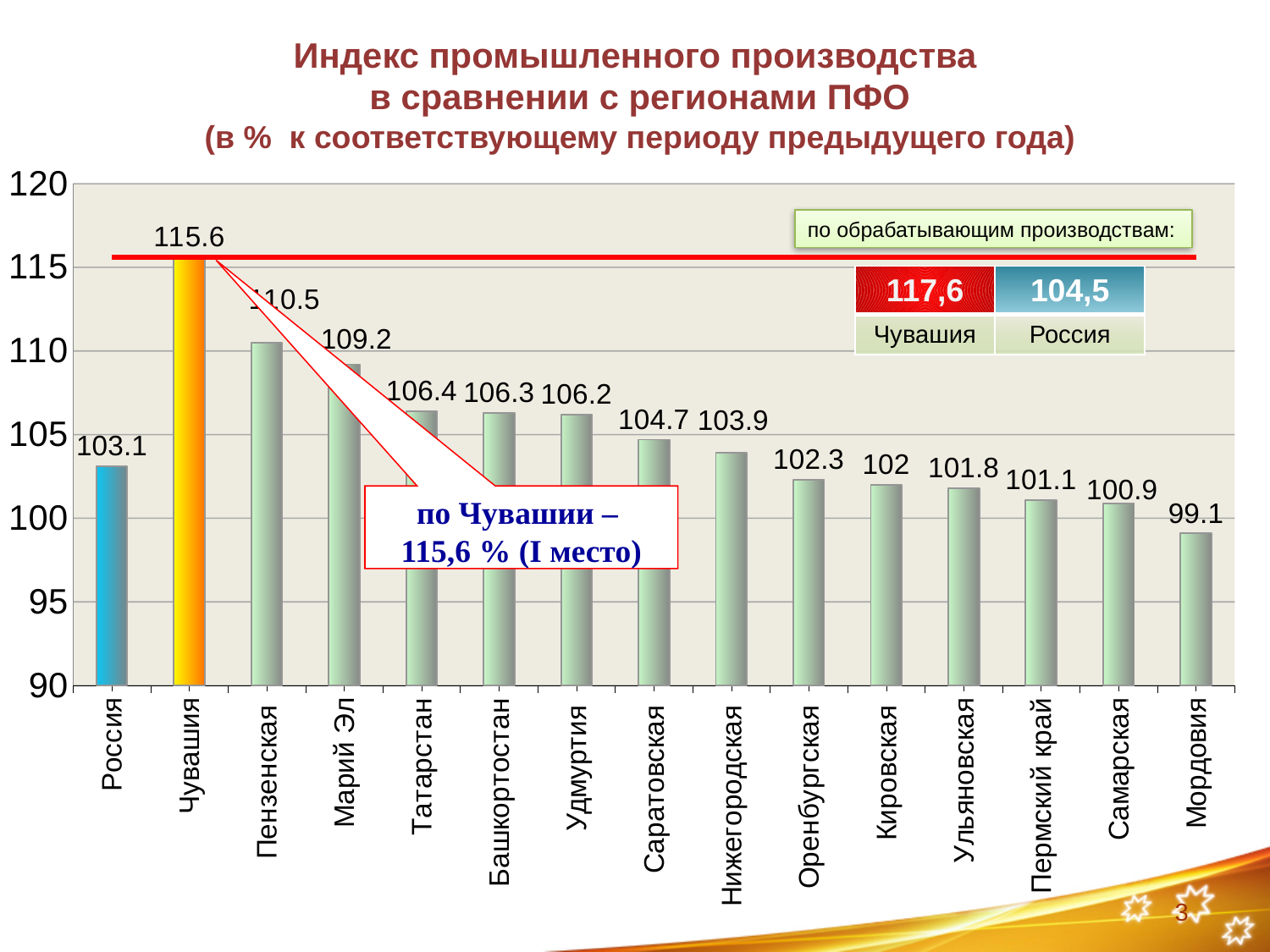
Is the value for Мордовия greater or less than 100? less Which is larger, the value for Пензенская or the value for Марий Эл? Пензенская What kind of chart is shown on the slide? bar chart Which category has the highest value? Чувашия Which category has the lowest value? Мордовия What is the value for Мордовия? 99.1 What is the value for Татарстан? 106.4 How many categories are shown on the x axis? 15 What is the value for Чувашия? 115.6 What is the value for Россия? 103.1 What value is shown for Чувашия in the box labelled 'по обрабатывающим производствам'? 117,6 What is the difference between the values for Чувашия and Россия? 12.5